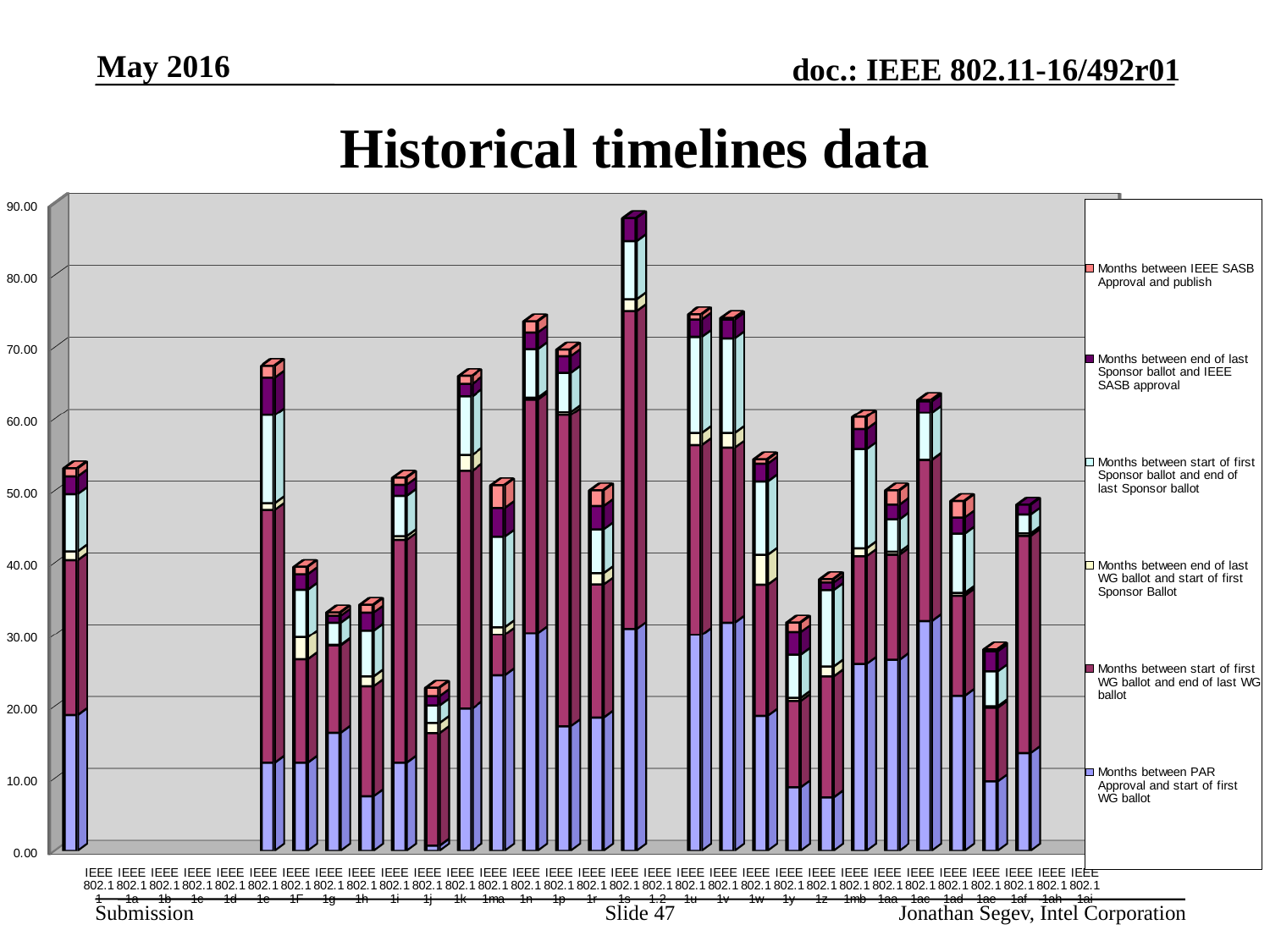
Which has the taller stacked bar, IEEE 802.11ac or IEEE 802.11ad? IEEE 802.11ac How many series does the legend list? 6 What kind of chart is shown on the slide? Stacked bar chart Which category has the tallest stacked bar? IEEE 802.11s Which legend entry corresponds to the bottom segment of each stacked bar? Months between PAR Approval and start of first WG ballot Is the total for IEEE 802.11j greater or less than 30.00? less Is the total for IEEE 802.11s greater or less than 80.00? greater Is the total for IEEE 802.11n greater or less than 70.00? greater Which has the taller stacked bar, IEEE 802.11e or IEEE 802.11g? IEEE 802.11e Among the categories with plotted bars, which has the shortest stacked bar? IEEE 802.11j